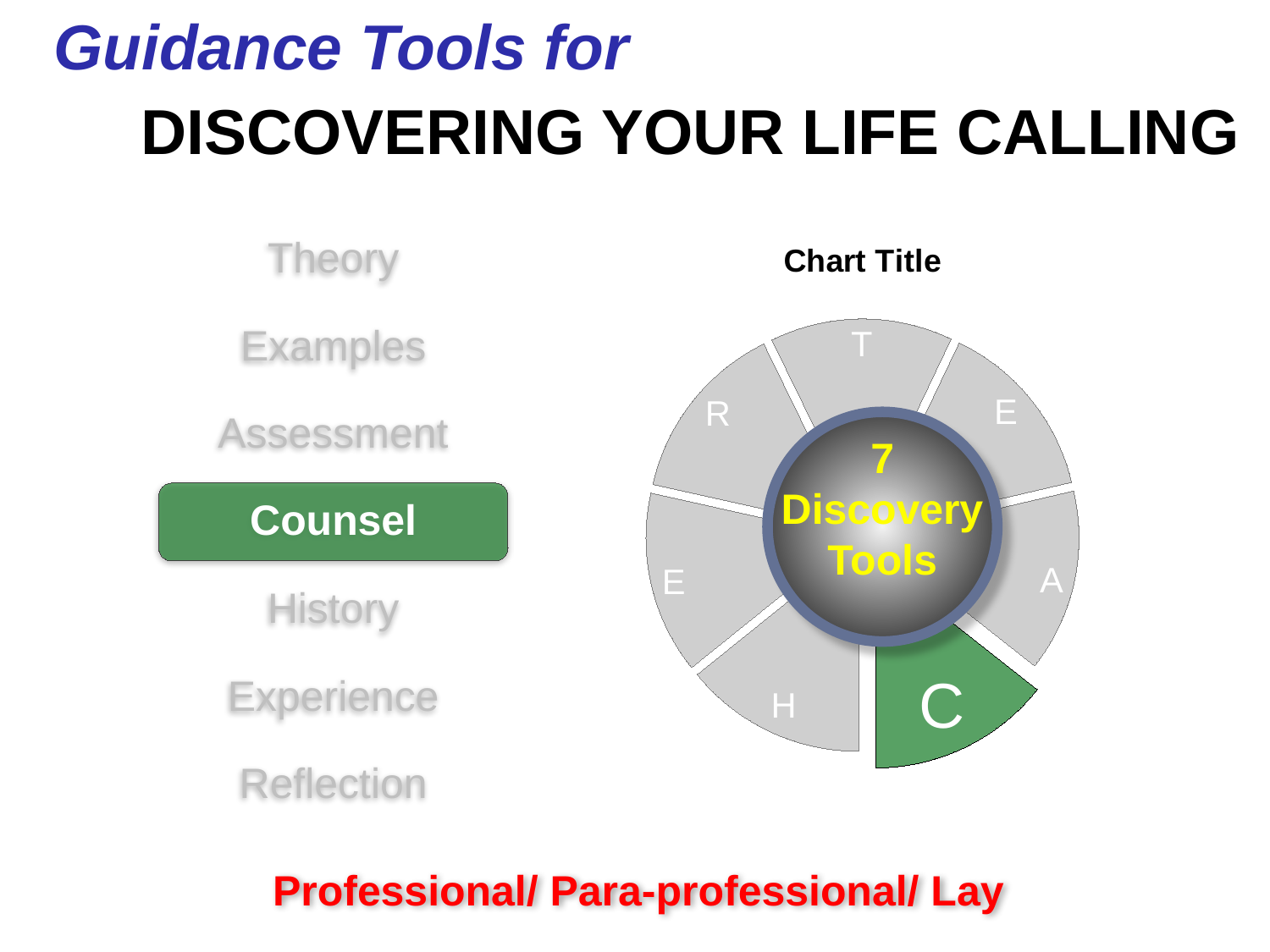
What is the title printed above the pie chart? Chart Title Which letter appears twice as a slice label in the pie chart? E Which letter labels the slice at the top of the pie chart? T What kind of chart is shown on the slide? pie chart What text is written in the centre circle of the pie chart? 7 Discovery Tools Which letter labels the slice at the bottom left of the pie chart, next to the green C slice? H Which letter labels the slice on the right side of the pie chart, directly above the green C slice? A Which slice of the pie chart is coloured green and pulled out from the rest? C Which letter labels the slice at the upper left of the pie chart, between E and T? R How many slices does the pie chart have? 7